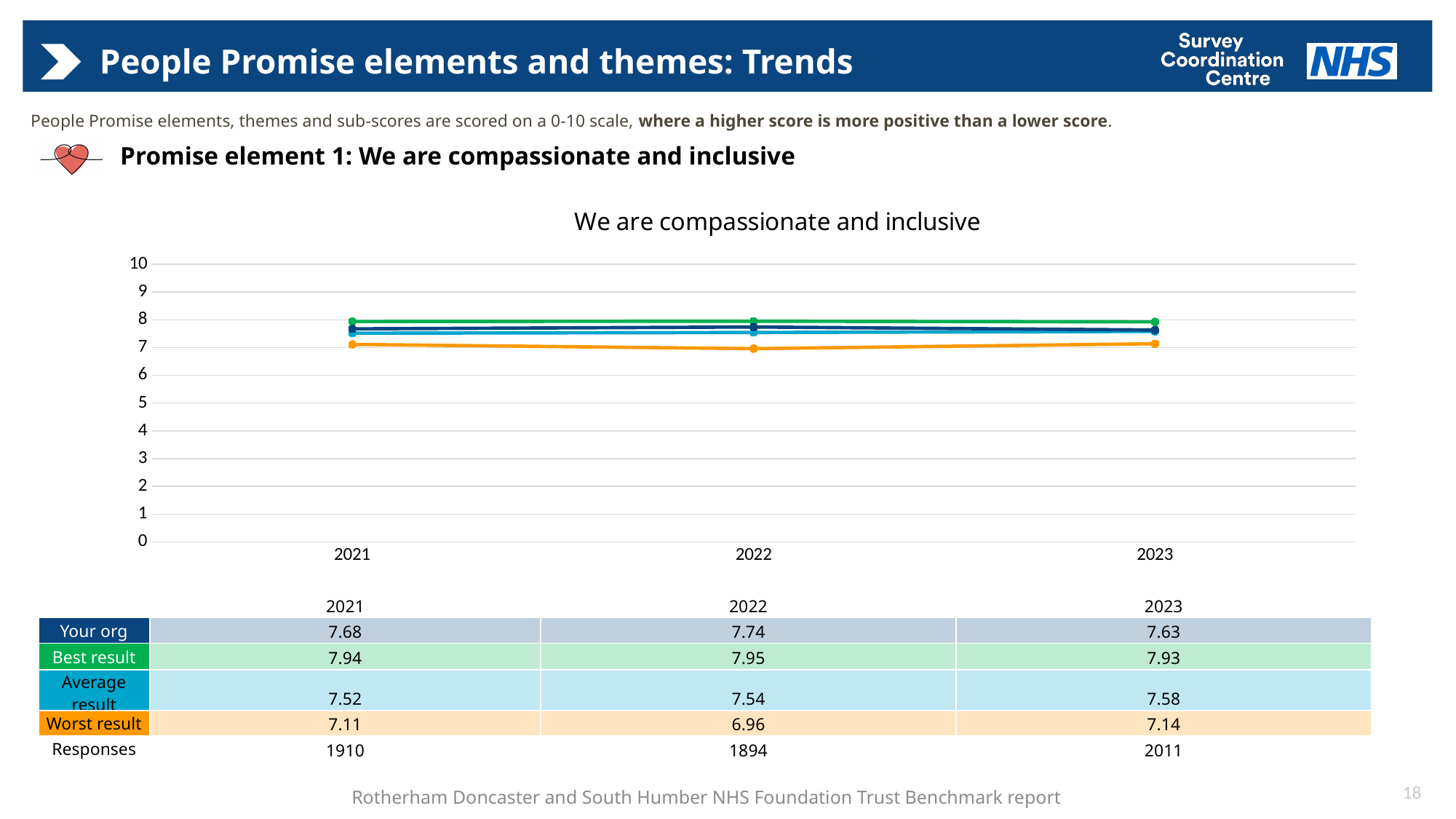
How many years are shown on the x axis? 3 Which is larger in 2021: the 'Your org' score or the 'Average result' score? Your org In which year was the 'Your org' score highest? 2022 What is the 'Best result' score for 2023? 7.93 What is the difference between the 'Best result' and 'Your org' scores in 2023? 0.30 What type of chart is shown on the slide? Line chart What is the title of the chart? We are compassionate and inclusive What is the 'Average result' score for 2021? 7.52 What is the 'Worst result' score for 2022? 6.96 In which year was the 'Worst result' score lowest? 2022 How many series are plotted on the chart? 4 What is the 'Your org' score for 2022? 7.74